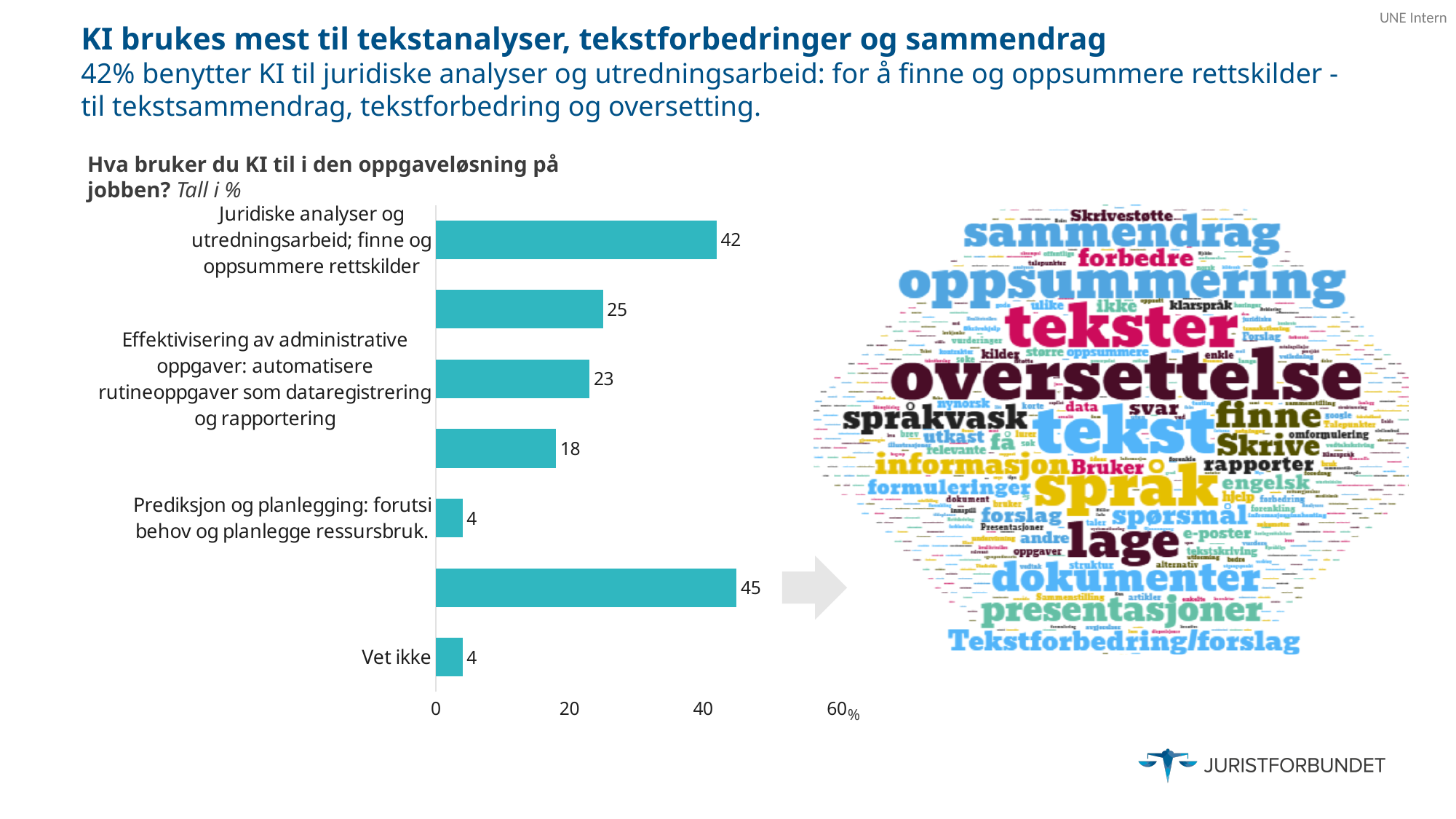
How many bars does the chart show? 7 What is the value for "Effektivisering av administrative oppgaver: automatisere rutineoppgaver som dataregistrering og rapportering"? 23 Is the value for "Juridiske analyser og utredningsarbeid; finne og oppsummere rettskilder" greater or less than 40? greater What is the difference between the value for "Juridiske analyser og utredningsarbeid; finne og oppsummere rettskilder" and the value for "Effektivisering av administrative oppgaver"? 19 What is the value for "Vet ikke"? 4 What is the value for "Prediksjon og planlegging: forutsi behov og planlegge ressursbruk."? 4 What is the value for "Juridiske analyser og utredningsarbeid; finne og oppsummere rettskilder"? 42 Which is larger: the value for "Juridiske analyser og utredningsarbeid" or the value for "Effektivisering av administrative oppgaver"? Juridiske analyser og utredningsarbeid What is the highest value shown on any bar in the chart? 45 What kind of chart is shown on the slide? bar chart What is the lowest value shown on any bar in the chart? 4 What is the title of the chart? Hva bruker du KI til i den oppgaveløsning på jobben?